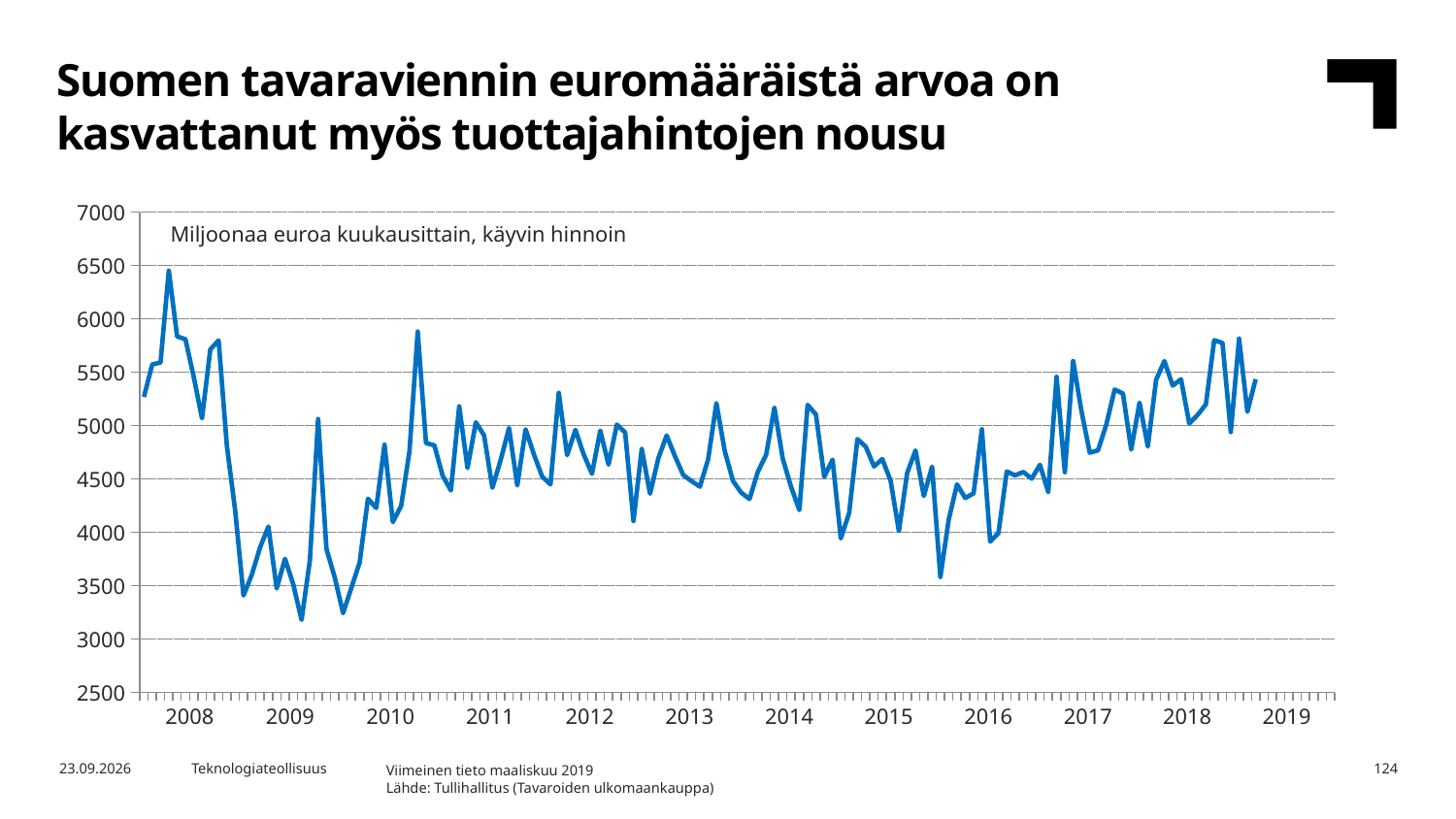
In which year does the line reach its lowest point? 2009 Is the highest value in 2018 greater or less than 5500? greater Do the values generally rise or fall from 2016 to 2018? rise Is the highest value in 2010 greater or less than 5500? greater Is the lowest value in 2009 greater or less than 3500? less What unit description is printed inside the chart area? Miljoonaa euroa kuukausittain, käyvin hinnoin What kind of chart is shown on the slide? line chart In which year does the line reach its highest point? 2008 Do the values generally rise or fall from 2008 into 2009? fall How many year labels are shown on the x axis? 12